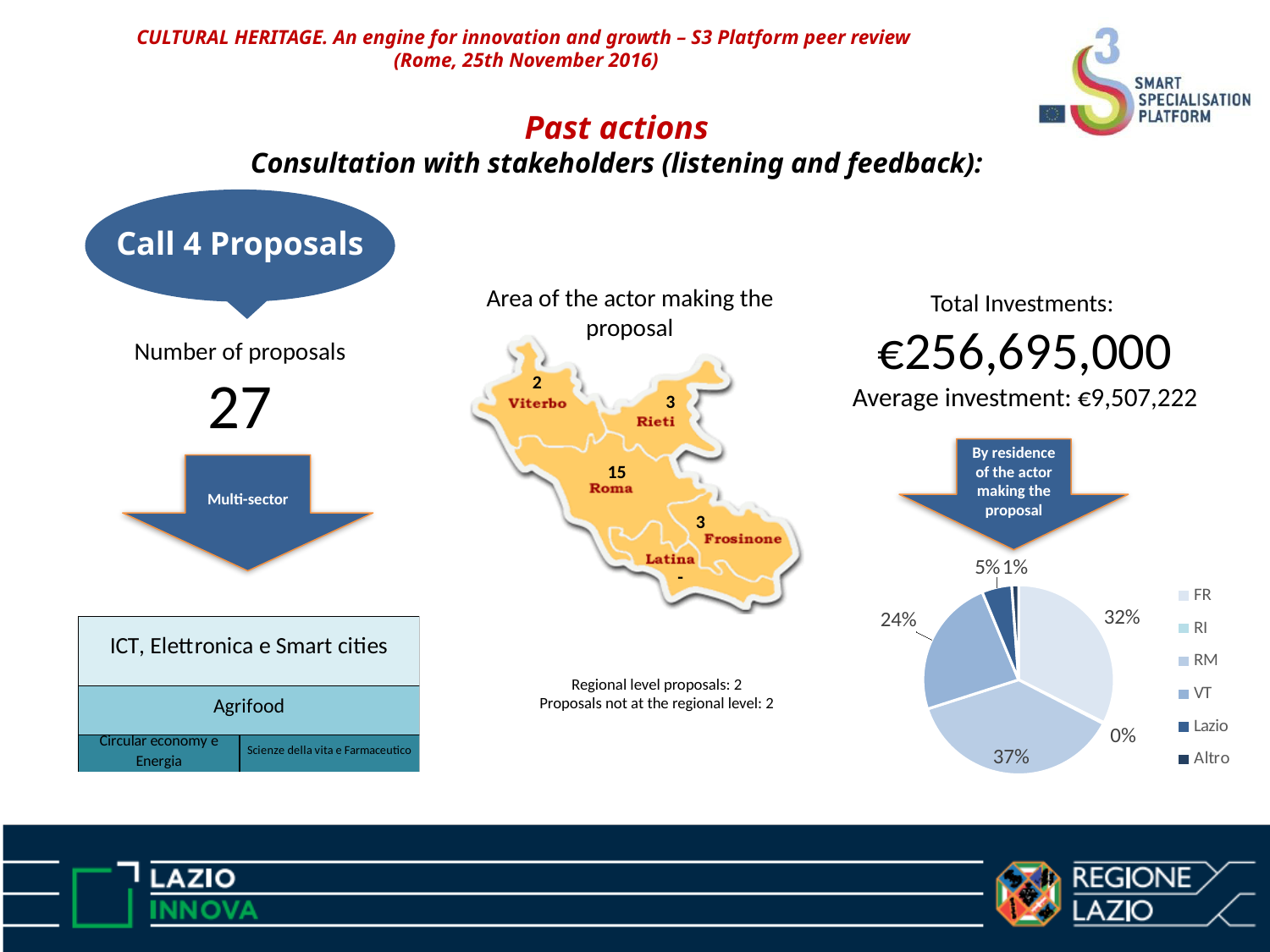
What kind of chart is shown under "By residence of the actor making the proposal"? pie chart In the pie chart, which slice is larger, VT or Lazio? VT Which legend entry has the largest slice in the pie chart? RM In the pie chart, what is the difference in percentage points between the RM and FR slices? 5 In the pie chart, what share is labelled for RM? 37% In the pie chart, what share is labelled for VT? 24% Which legend entry has the smallest slice in the pie chart? RI In the pie chart, what share is labelled for Lazio? 5% In the pie chart, what share is labelled for FR? 32% How many entries does the legend of the pie chart list? 6 In the pie chart, what share is labelled for RI? 0% Which legend entry in the pie chart is shown in the darkest blue? Altro